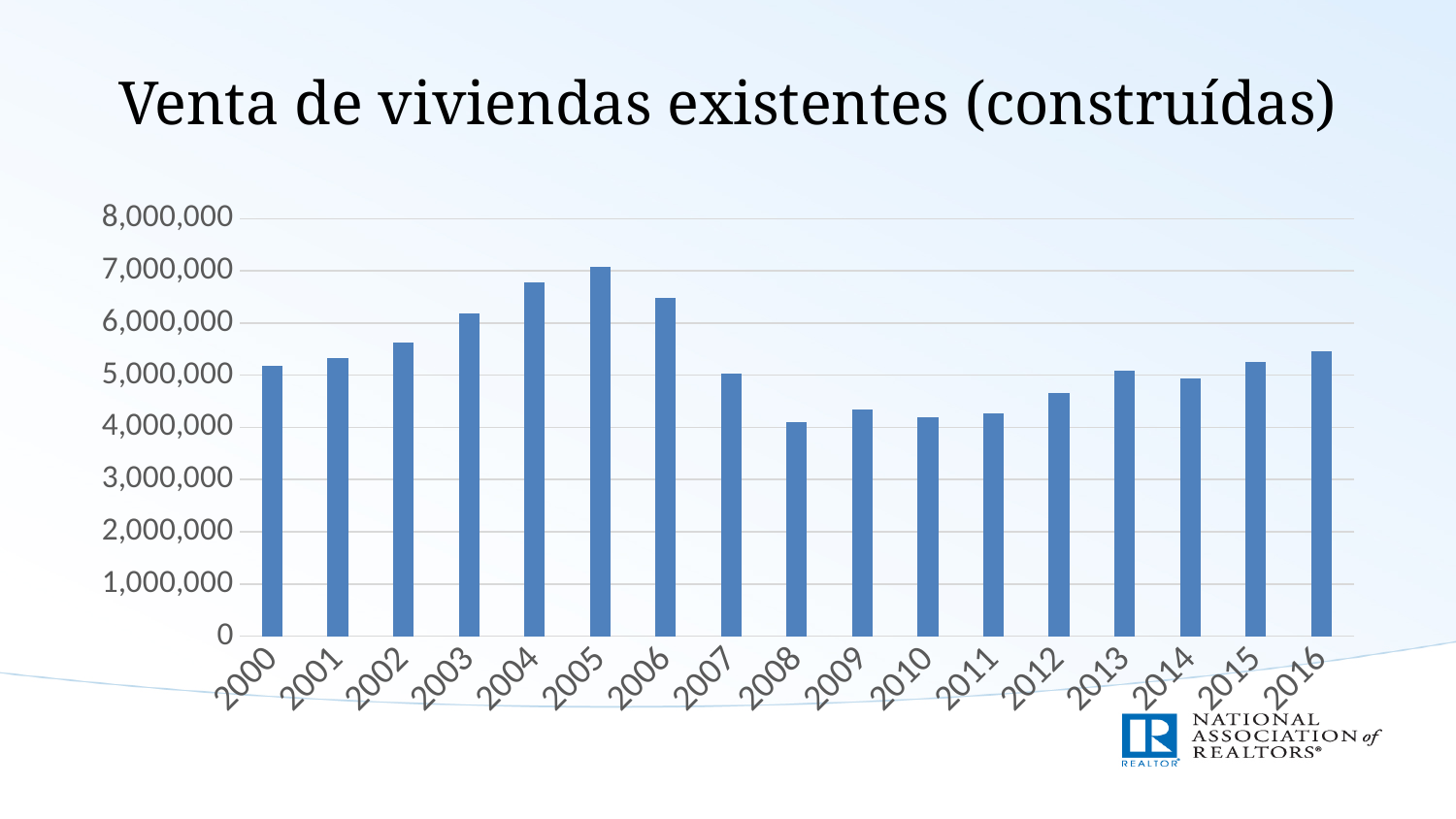
Do the values rise or fall from 2000 to 2005? rise Is the value for 2016 greater or less than 5,000,000? greater Is the value for 2004 greater or less than 6,000,000? greater Is the value for 2012 greater or less than 5,000,000? less Which is larger, the value for 2002 or the value for 2007? 2002 What kind of chart is shown on the slide? Bar chart Do the values rise or fall from 2005 to 2008? fall Which is larger, the value for 2004 or the value for 2006? 2004 What is the title of the chart on the slide? Venta de viviendas existentes (construídas) How many years are shown on the x axis of the chart? 17 Which year has the highest value in the chart? 2005